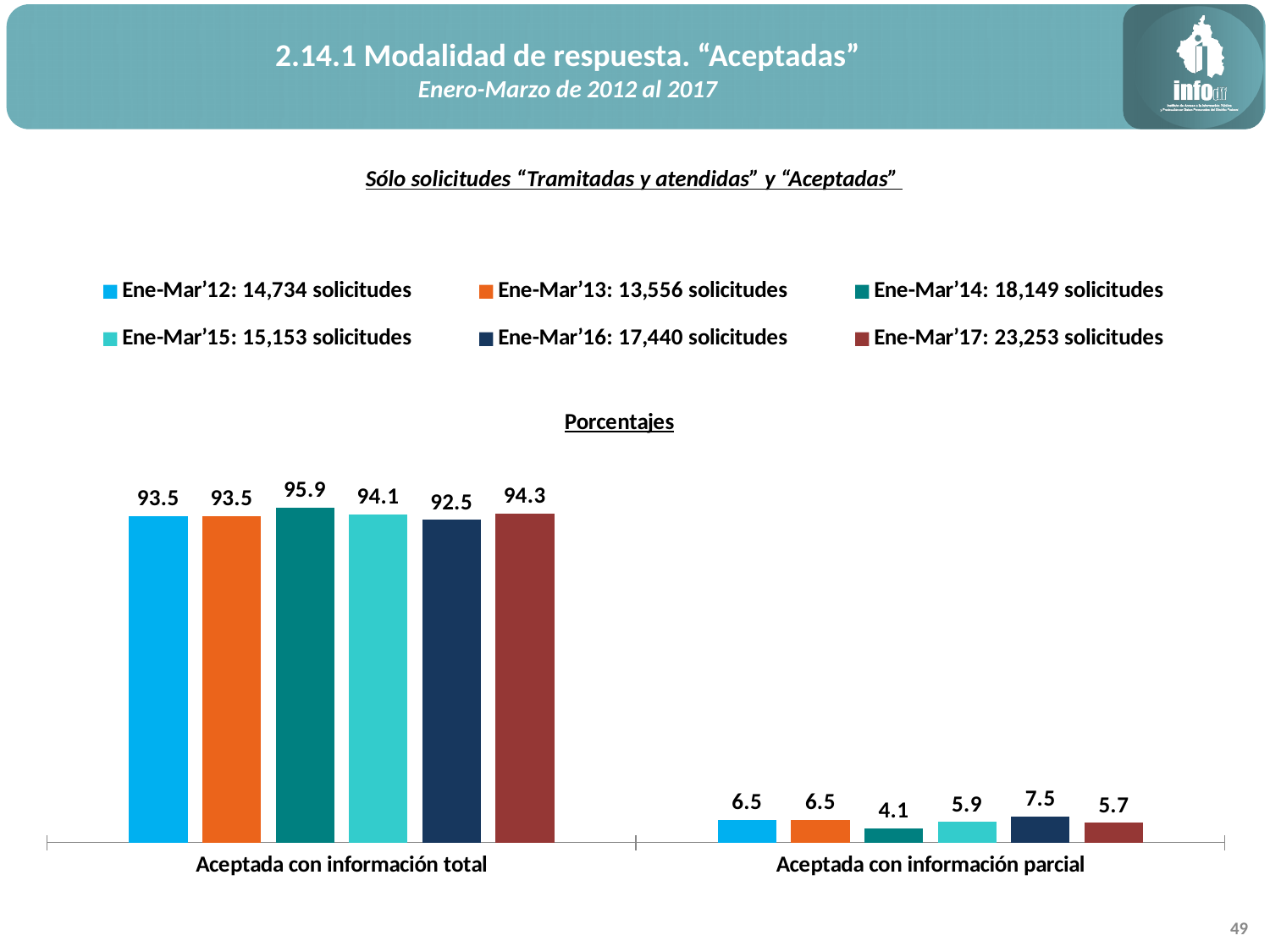
How many categories are shown on the x axis? 2 What is the difference between the Ene-Mar'16 and Ene-Mar'14 values in the "Aceptada con información parcial" category? 3.4 What kind of chart is shown on the slide? bar chart What is the value for Ene-Mar'16 in the "Aceptada con información parcial" category? 7.5 Which series has the lowest value in the "Aceptada con información parcial" category? Ene-Mar'14: 18,149 solicitudes What is the value for Ene-Mar'14 in the "Aceptada con información total" category? 95.9 What is the difference between the Ene-Mar'14 and Ene-Mar'16 values in the "Aceptada con información total" category? 3.4 Which is larger in the "Aceptada con información parcial" category: the value for Ene-Mar'15 or the value for Ene-Mar'17? Ene-Mar'15 What is the title shown above the chart? Porcentajes How many series does the legend list? 6 What is the value for Ene-Mar'12 in the "Aceptada con información total" category? 93.5 Which series has the highest value in the "Aceptada con información total" category? Ene-Mar'14: 18,149 solicitudes